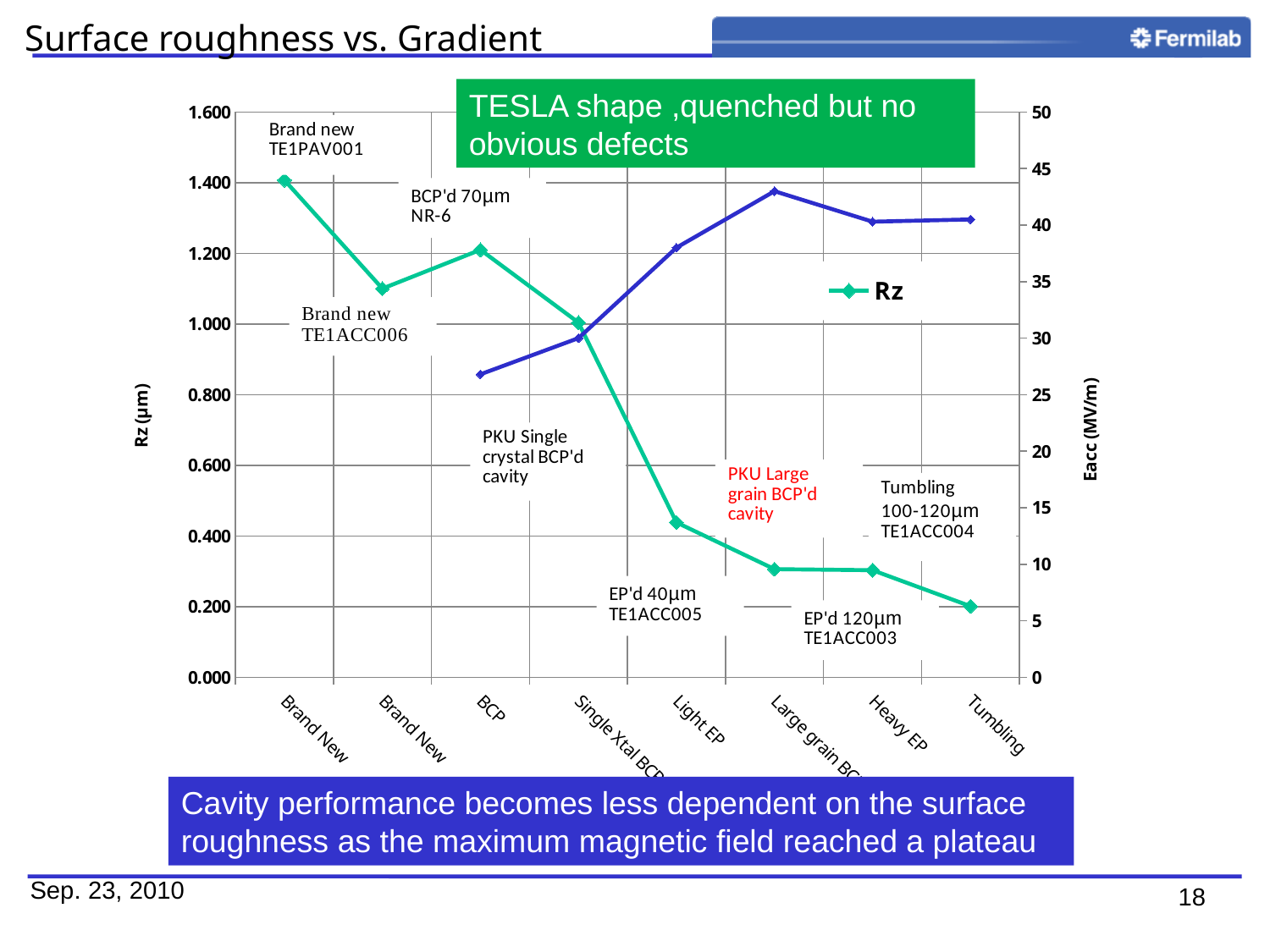
How many series does the chart's legend list? 1 Do the Rz values generally rise or fall from left to right along the x axis? fall How many categories are shown along the x axis of the chart? 8 Is the Eacc value for BCP greater or less than 30? less Which category has the lowest Rz value? Tumbling What is the label of the right-hand vertical axis? Eacc (MV/m) Which has a larger Rz value, Light EP or Tumbling? Light EP What kind of chart is shown on the slide? line chart Is the Rz value for Tumbling greater or less than 0.400? less Which category has the highest Rz value? Brand New (first) Is the Rz value for Light EP greater or less than 0.600? less